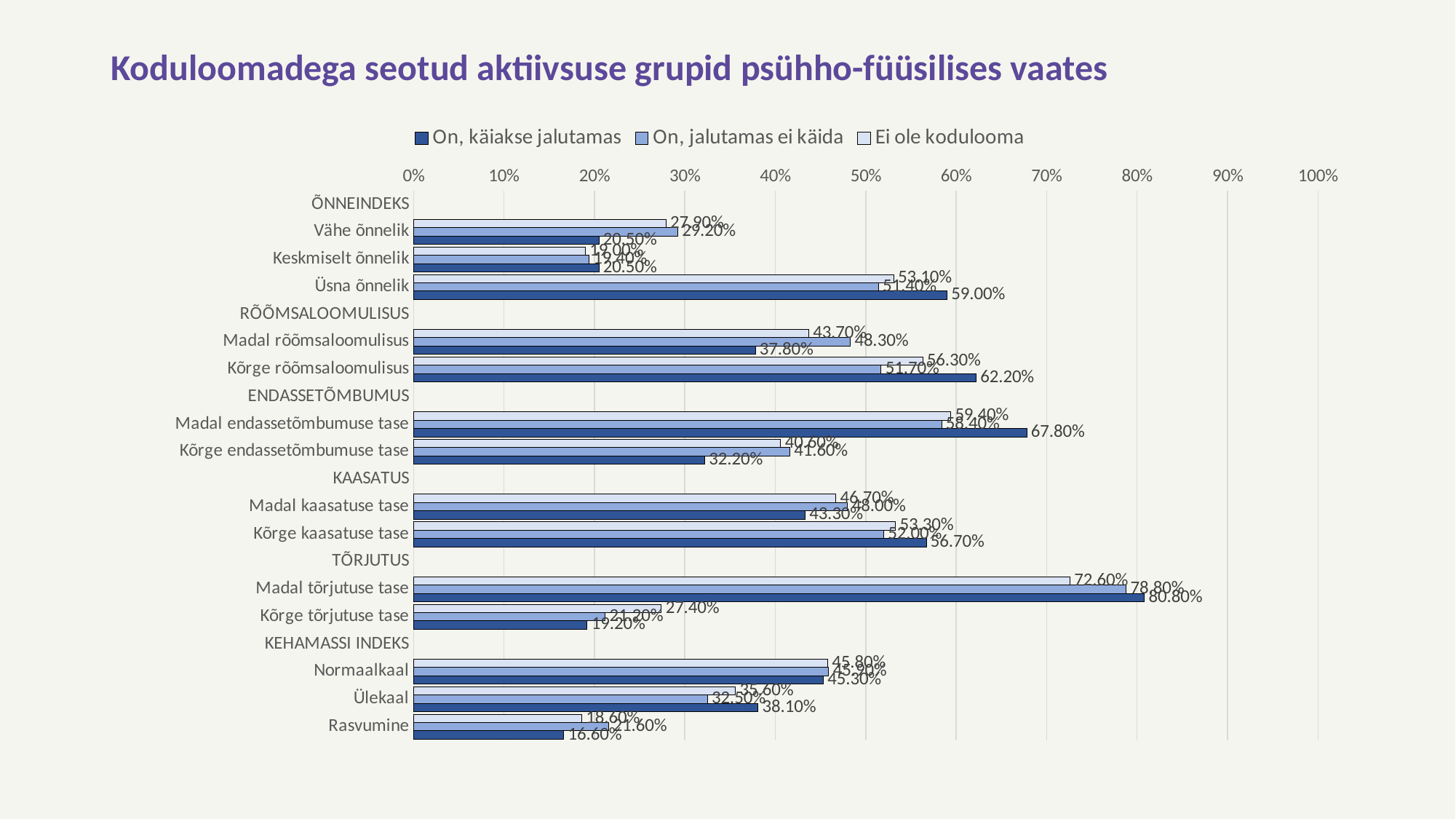
For Kõrge rõõmsaloomulisus, which is larger: the value for "On, käiakse jalutamas" or for "On, jalutamas ei käida"? On, käiakse jalutamas What is the value for "On, käiakse jalutamas" in the Üsna õnnelik category? 59.00% Which category has the highest value for the "On, käiakse jalutamas" series? Madal tõrjutuse tase Is the value for "On, käiakse jalutamas" in the Kõrge endassetõmbumuse tase category greater or less than 40%? less What is the difference between the "On, käiakse jalutamas" and "Ei ole kodulooma" values for Madal endassetõmbumuse tase? 8.40% What is the value for "On, jalutamas ei käida" in the Madal rõõmsaloomulisus category? 48.30% What kind of chart is shown on the slide? bar chart What is the title of the chart? Koduloomadega seotud aktiivsuse grupid psühho-füüsilises vaates Which category has the lowest value for the "Ei ole kodulooma" series? Rasvumine What is the value for "On, käiakse jalutamas" in the Rasvumine category? 16.60% How many series does the legend list? 3 What is the value for "Ei ole kodulooma" in the Madal tõrjutuse tase category? 72.60%